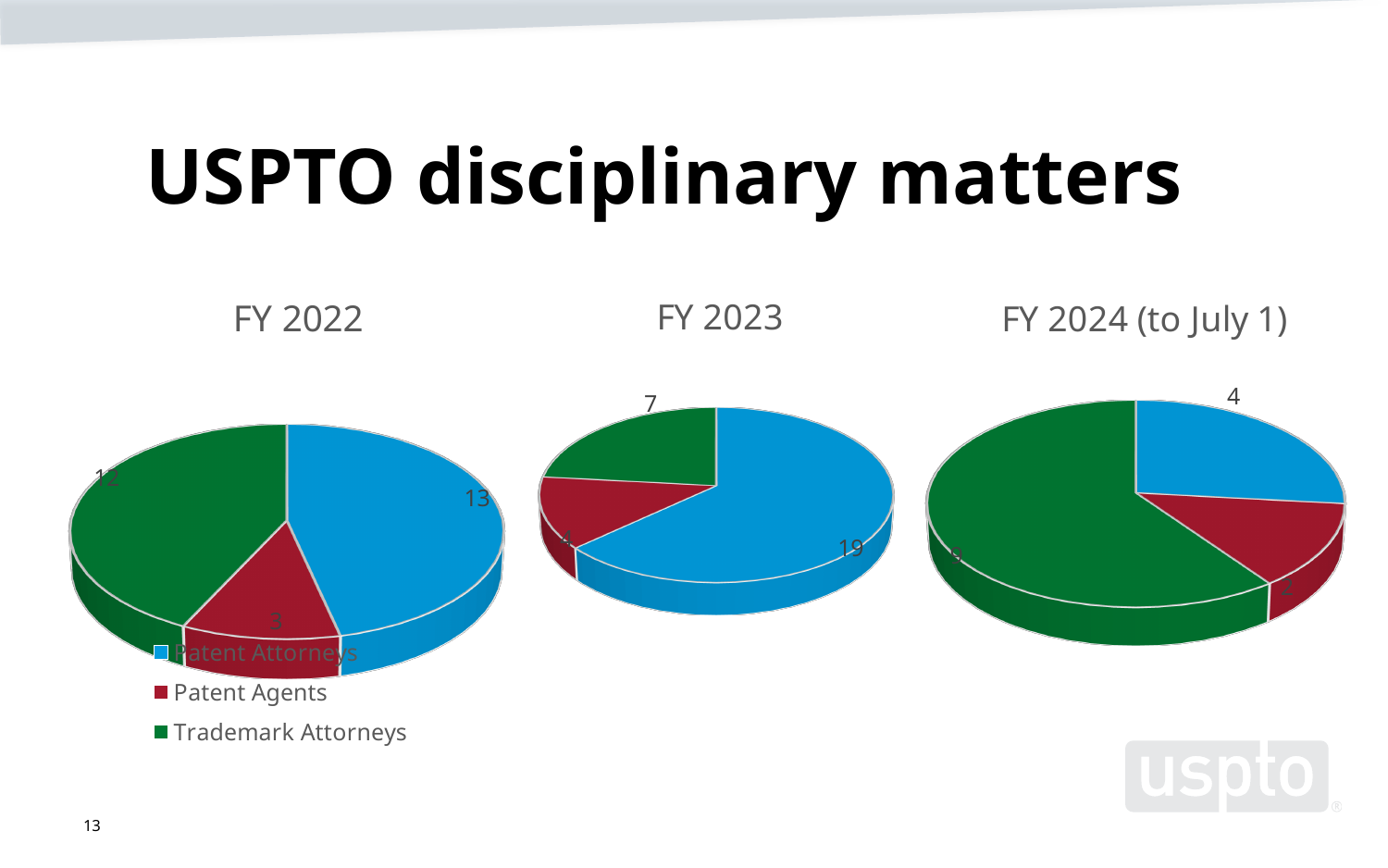
In the FY 2024 (to July 1) chart, what is the value for Patent Attorneys? 4 In the FY 2023 chart, what is the value for Trademark Attorneys? 7 In the FY 2024 (to July 1) chart, which category has the largest slice? Trademark Attorneys How many series does the legend list? 3 In the FY 2022 chart, what is the value for Patent Agents? 3 In the FY 2022 chart, what is the total of all three slices? 28 In the FY 2022 chart, what is the value for Patent Attorneys? 13 In the FY 2023 chart, what is the difference between the values for Patent Attorneys and Trademark Attorneys? 12 In the FY 2022 chart, what is the value for Trademark Attorneys? 12 In the FY 2022 chart, which category has the smallest slice? Patent Agents What kind of chart is used for FY 2023? Pie chart In the FY 2023 chart, what is the value for Patent Attorneys? 19